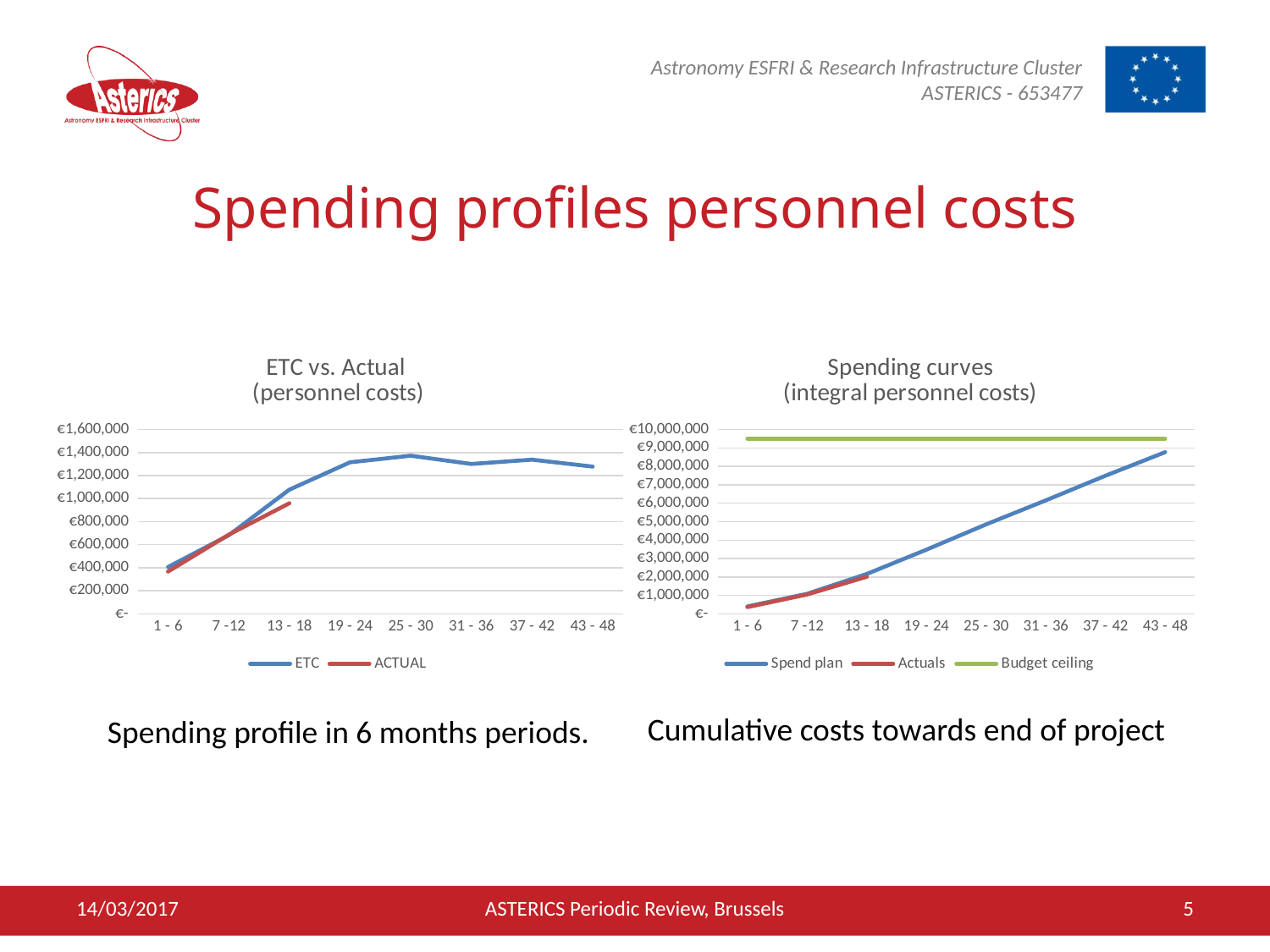
In the 'Spending curves (integral personnel costs)' chart, is the Budget ceiling greater or less than €9,000,000? greater In the 'Spending curves (integral personnel costs)' chart, which series is drawn in green? Budget ceiling In the 'ETC vs. Actual (personnel costs)' chart, is the ETC value for 19 - 24 greater or less than €1,200,000? greater In the 'ETC vs. Actual (personnel costs)' chart, is the ETC value for 1 - 6 greater or less than €600,000? less What kind of chart is the 'ETC vs. Actual (personnel costs)' chart? line chart How many periods are shown on the x axis of the 'Spending curves (integral personnel costs)' chart? 8 In the 'Spending curves (integral personnel costs)' chart, does the Spend plan line rise or fall from 1 - 6 to 43 - 48? rise How many series does the legend of the 'Spending curves (integral personnel costs)' chart list? 3 What is the title of the chart on the left of the slide? ETC vs. Actual (personnel costs) In the 'Spending curves (integral personnel costs)' chart, which is larger at 43 - 48: the Spend plan or the Budget ceiling? Budget ceiling How many series does the legend of the 'ETC vs. Actual (personnel costs)' chart list? 2